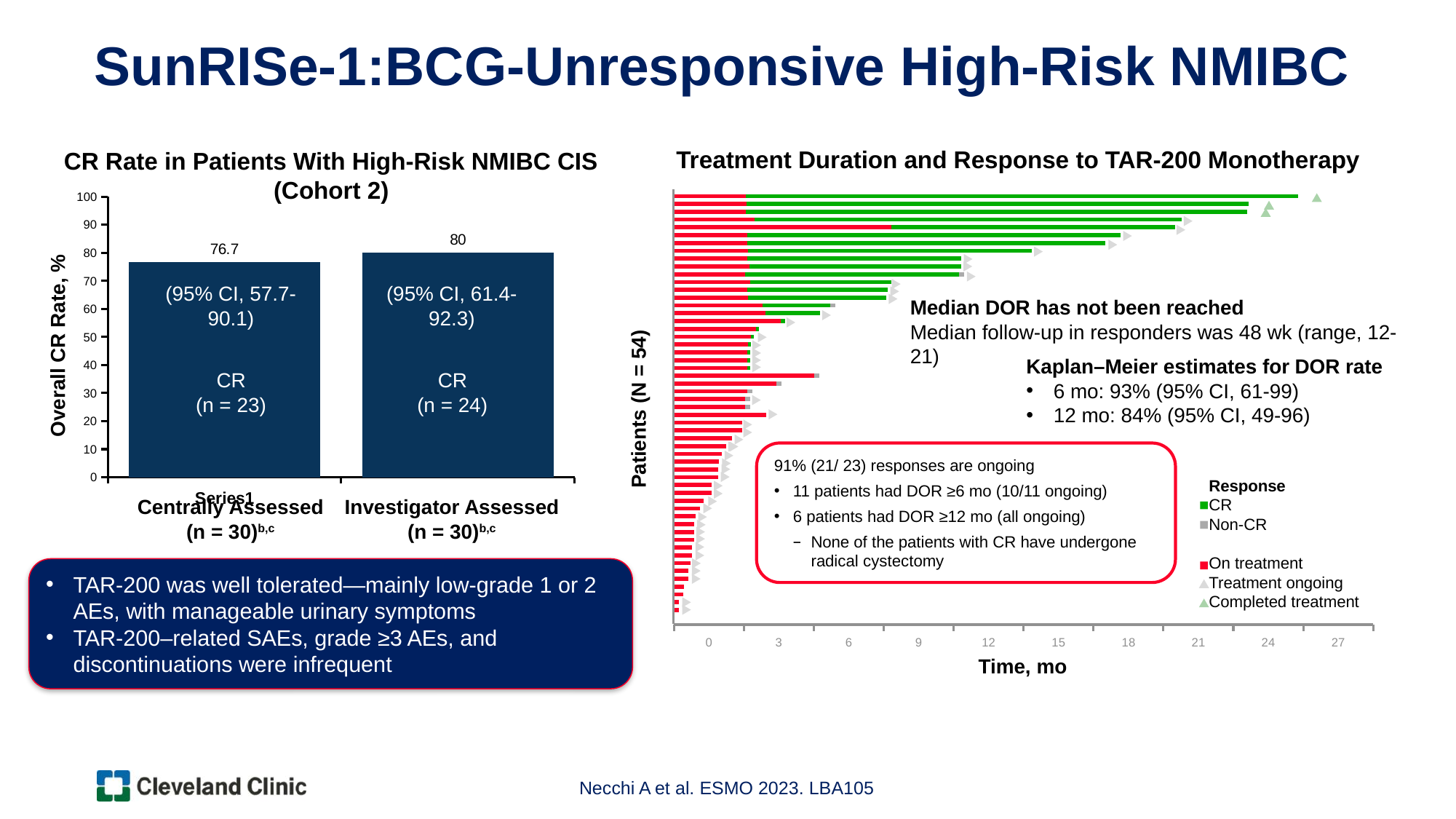
In the CR Rate in Patients With High-Risk NMIBC CIS (Cohort 2) chart, what is the overall CR rate for the Investigator Assessed group? 80 In the Treatment Duration and Response to TAR-200 Monotherapy chart, what is the highest tick value shown on the x axis? 27 In the CR Rate in Patients With High-Risk NMIBC CIS (Cohort 2) chart, how many bars are plotted? 2 In the CR Rate in Patients With High-Risk NMIBC CIS (Cohort 2) chart, how many patients achieved CR in the Centrally Assessed group? n = 23 In the CR Rate in Patients With High-Risk NMIBC CIS (Cohort 2) chart, what is the difference between the Investigator Assessed and Centrally Assessed CR rates? 3.3 In the Treatment Duration and Response to TAR-200 Monotherapy chart, is the longest treatment duration bar greater or less than 21 months? greater In the CR Rate in Patients With High-Risk NMIBC CIS (Cohort 2) chart, which group has the higher overall CR rate? Investigator Assessed In the CR Rate in Patients With High-Risk NMIBC CIS (Cohort 2) chart, what is the overall CR rate for the Centrally Assessed group? 76.7 In the CR Rate in Patients With High-Risk NMIBC CIS (Cohort 2) chart, what is the label of the y axis? Overall CR Rate, % In the Treatment Duration and Response to TAR-200 Monotherapy chart, how many patients are represented according to the y axis label? N = 54 In the Treatment Duration and Response to TAR-200 Monotherapy chart, what is the label of the x axis? Time, mo What kind of chart is the CR Rate in Patients With High-Risk NMIBC CIS (Cohort 2) chart? Bar chart